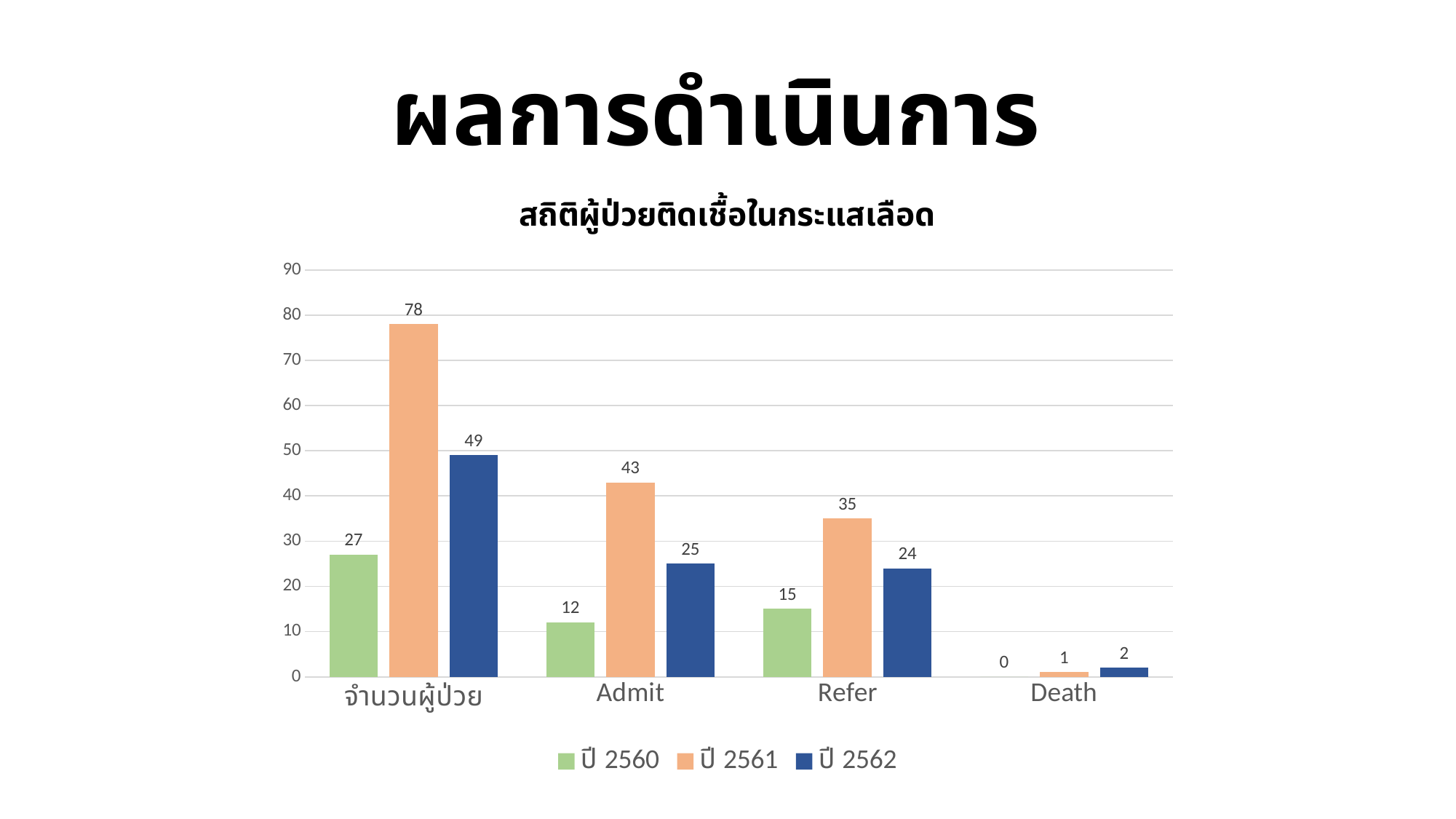
What is the title of the chart? สถิติผู้ป่วยติดเชื้อในกระแสเลือด Which category has the highest value for ปี 2562? จำนวนผู้ป่วย Which is larger in the Refer category: the value for ปี 2561 or ปี 2562? ปี 2561 What kind of chart is shown on the slide? Bar chart What is the value for ปี 2562 in the Admit category? 25 How many series does the legend list? 3 How many categories are shown on the x axis? 4 What is the value for ปี 2561 in the จำนวนผู้ป่วย category? 78 Which category has the lowest value for ปี 2560? Death What is the difference between the ปี 2561 and ปี 2562 values in the จำนวนผู้ป่วย category? 29 What is the value for ปี 2560 in the Refer category? 15 What is the value for ปี 2561 in the Death category? 1